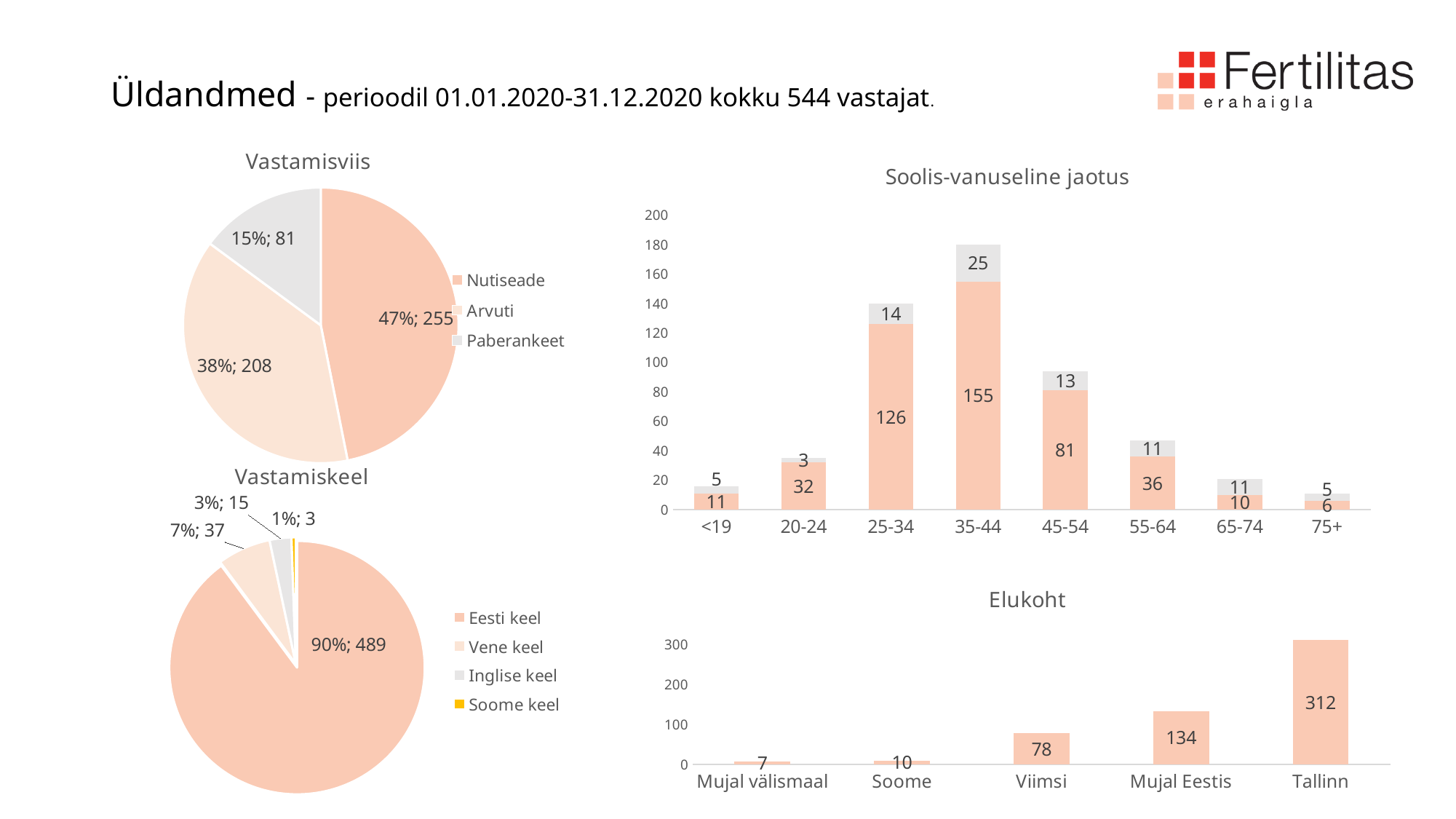
In the Vastamisviis pie chart, what share of respondents used Nutiseade? 47% In the Vastamiskeel pie chart, what share of respondents answered in Eesti keel? 90% How many age groups are shown on the x axis of the Soolis-vanuseline jaotus chart? 8 In the Soolis-vanuseline jaotus chart, what is the total of the stacked bar for the 35-44 age group? 180 In the Soolis-vanuseline jaotus chart, what is the value of the lower (peach) segment for the 25-34 age group? 126 In the Elukoht chart, what is the difference between the values for Tallinn and Mujal Eestis? 178 In the Elukoht chart, which category has the highest value? Tallinn In the Vastamisviis pie chart, how many respondents answered via Paberankeet? 81 In the Soolis-vanuseline jaotus chart, which age group has the tallest stacked bar? 35-44 What kind of chart is the Elukoht chart? Bar chart How many categories does the Vastamiskeel pie chart legend list? 4 In the Vastamiskeel pie chart, how many respondents answered in Soome keel? 3